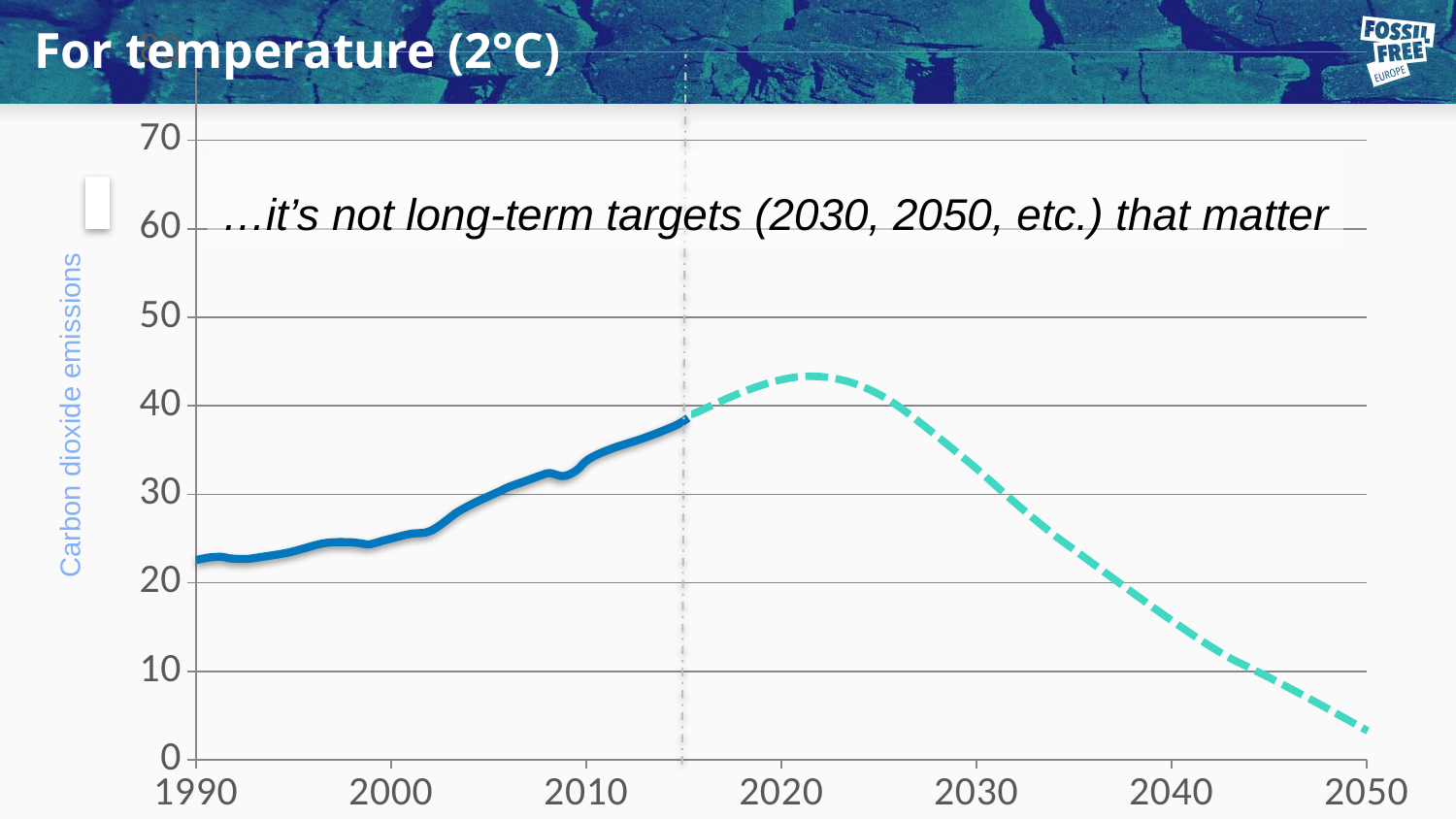
What kind of chart is shown on the slide? line chart Is the value of the solid line in 2010 greater or less than 40? less Is the value of the solid line in 1990 greater or less than 30? less What is the label on the vertical axis of the chart? Carbon dioxide emissions Is the value of the dashed line in 2050 greater or less than 10? less Does the solid line rise or fall between 1990 and 2015? rise Does the dashed line rise or fall between 2030 and 2050? fall What is the title of the slide containing the chart? For temperature (2°C) Which year has the higher value on the chart, 2010 or 1990? 2010